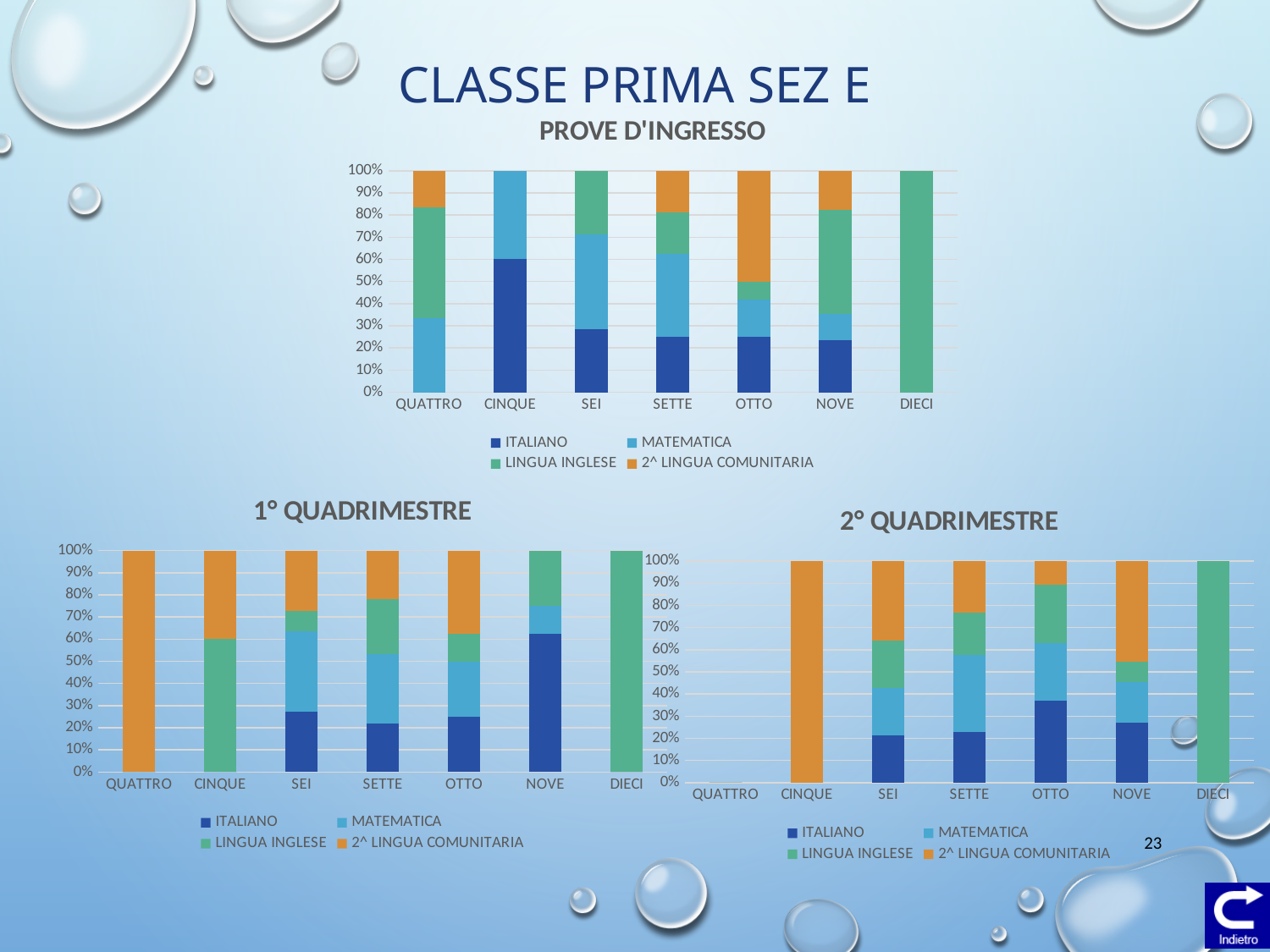
Which series is shown in orange in the 1° QUADRIMESTRE chart? 2^ LINGUA COMUNITARIA In the 2° QUADRIMESTRE chart, which category has the largest ITALIANO segment? OTTO In the PROVE D'INGRESSO chart, what share of the DIECI bar is LINGUA INGLESE? 100% In the 1° QUADRIMESTRE chart, is the ITALIANO value for NOVE greater or less than 50%? greater What kind of chart is the PROVE D'INGRESSO chart? Stacked bar chart In the 1° QUADRIMESTRE chart, what share of the QUATTRO bar is 2^ LINGUA COMUNITARIA? 100% How many series does the legend of the 2° QUADRIMESTRE chart list? 4 How many categories are shown on the x axis of the 1° QUADRIMESTRE chart? 7 In the PROVE D'INGRESSO chart, is the ITALIANO value for CINQUE greater or less than 50%? greater In the PROVE D'INGRESSO chart, which category has the largest ITALIANO segment? CINQUE What is the title of the chart at the top of the slide? PROVE D'INGRESSO In the PROVE D'INGRESSO chart, is the ITALIANO value for SEI greater or less than 40%? less